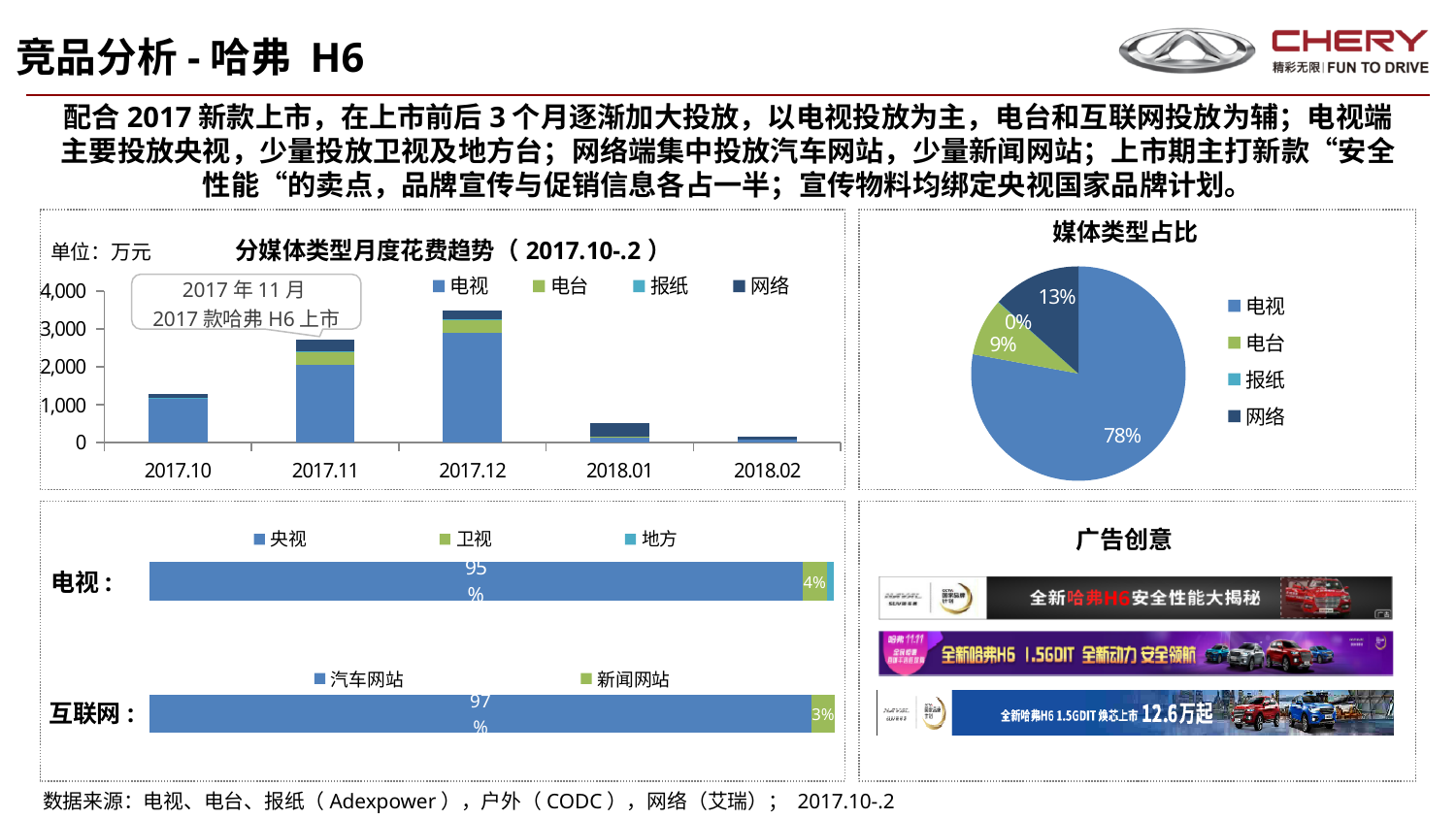
How many entries does the legend of the pie chart 媒体类型占比 list? 4 In the 互联网 bar at the bottom left, what share does 汽车网站 account for? 97% In the pie chart 媒体类型占比, how many percentage points larger is 网络 than 电台? 4% In the pie chart 媒体类型占比, which media type has the largest slice? 电视 In the pie chart 媒体类型占比, what share does 电视 have? 78% In the 电视 bar at the bottom left, what share does 央视 account for? 95% In the chart 分媒体类型月度花费趋势（2017.10-.2）, which month has the highest total spend? 2017.12 In the chart 分媒体类型月度花费趋势（2017.10-.2）, is the total for 2017.12 greater or less than 3,000? greater What kind of chart is 分媒体类型月度花费趋势（2017.10-.2）? stacked bar chart In the chart 分媒体类型月度花费趋势（2017.10-.2）, is the total for 2018.01 greater or less than 1,000? less In the pie chart 媒体类型占比, what is the share for 网络? 13% How many months are shown on the x axis of the chart 分媒体类型月度花费趋势（2017.10-.2）? 5